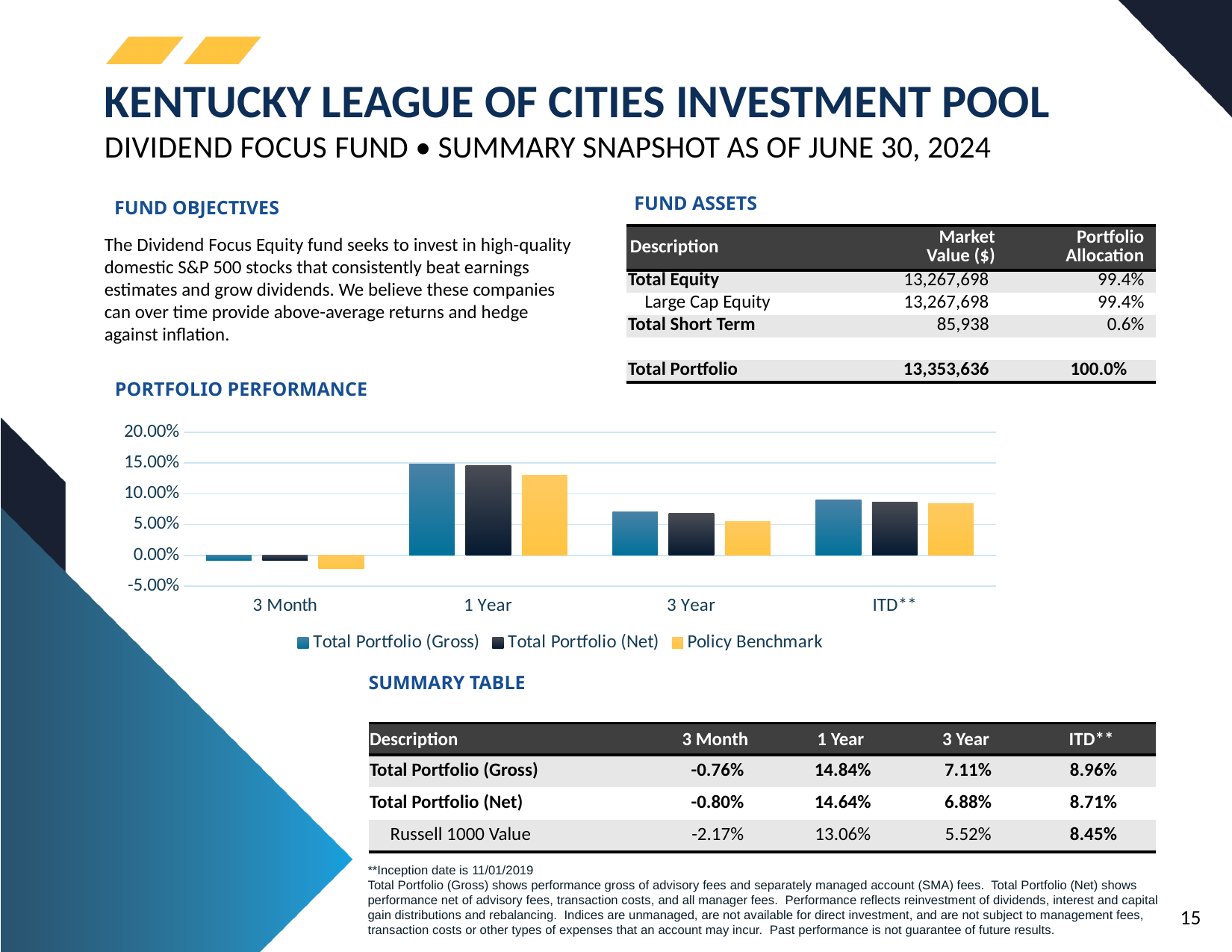
How many series does the legend of the Portfolio Performance chart list? 3 What kind of chart is shown under Portfolio Performance? bar chart In the Portfolio Performance chart, what colour represents the Policy Benchmark series? yellow In the Portfolio Performance chart, do the Total Portfolio (Gross) values rise or fall from 3 Month to 1 Year? rise According to the slide, what is the difference between the Total Portfolio (Gross) and Total Portfolio (Net) returns for 1 Year? 0.20% According to the slide, what is the Total Portfolio (Gross) return for 1 Year plotted in the Portfolio Performance chart? 14.84% In the Portfolio Performance chart, which period has the lowest Total Portfolio (Gross) return? 3 Month How many time periods are shown on the x axis of the Portfolio Performance chart? 4 In the Portfolio Performance chart, is the Total Portfolio (Gross) value for 1 Year greater or less than 10.00%? greater In the Portfolio Performance chart, is the Policy Benchmark value for 3 Year greater or less than 10.00%? less In the Portfolio Performance chart, for 1 Year, which is larger: Total Portfolio (Gross) or Policy Benchmark? Total Portfolio (Gross) In the Portfolio Performance chart, which period has the highest Total Portfolio (Gross) return? 1 Year